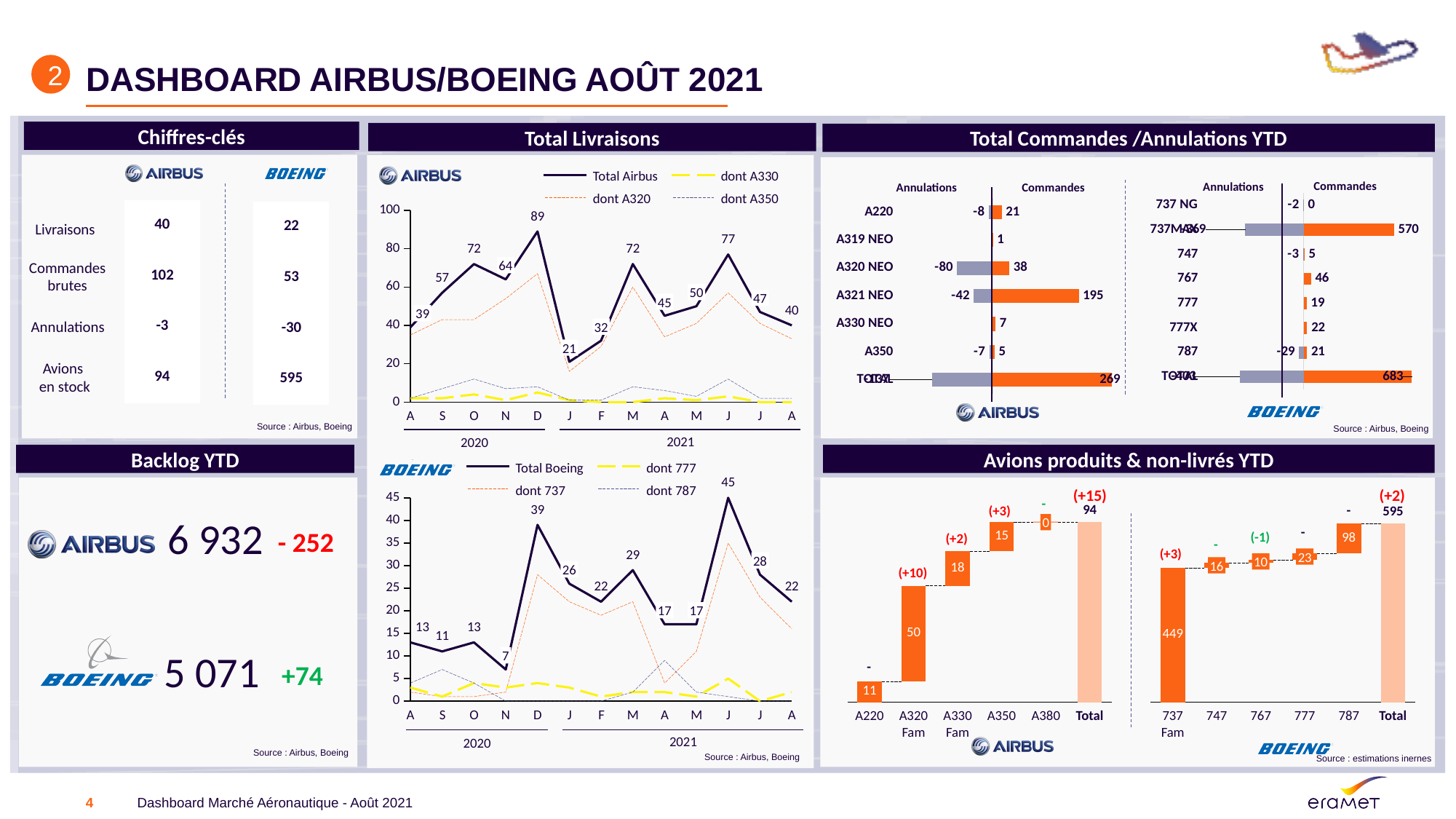
In the Boeing 'Total Livraisons' line chart, which month has the highest Total Boeing value? June 2021 In the Boeing 'Total Commandes /Annulations YTD' bar chart, how many Annulations are shown for the 737 MAX? -369 What kind of chart is used for 'Total Livraisons'? line chart In the Airbus 'Total Livraisons' line chart, which month has the lowest Total Airbus value? January 2021 In the Boeing 'Total Livraisons' line chart, is the Total Boeing value for November 2020 larger or smaller than the value for December 2020? smaller In the Airbus 'Total Commandes /Annulations YTD' bar chart, how many Commandes are shown for the A321 NEO? 195 In the Airbus 'Total Livraisons' line chart, what is the Total Airbus value for December 2020? 89 In the Airbus 'Total Livraisons' line chart, what is the difference between the Total Airbus values for December 2020 and January 2021? 68 In the Airbus 'Avions produits & non-livrés YTD' chart, what is the value for the A320 Fam? 50 How many series does the legend of the Airbus 'Total Livraisons' line chart list? 4 In the Boeing 'Total Livraisons' line chart, what is the Total Boeing value for June 2021? 45 In the Boeing 'Avions produits & non-livrés YTD' chart, what is the Total value? 595